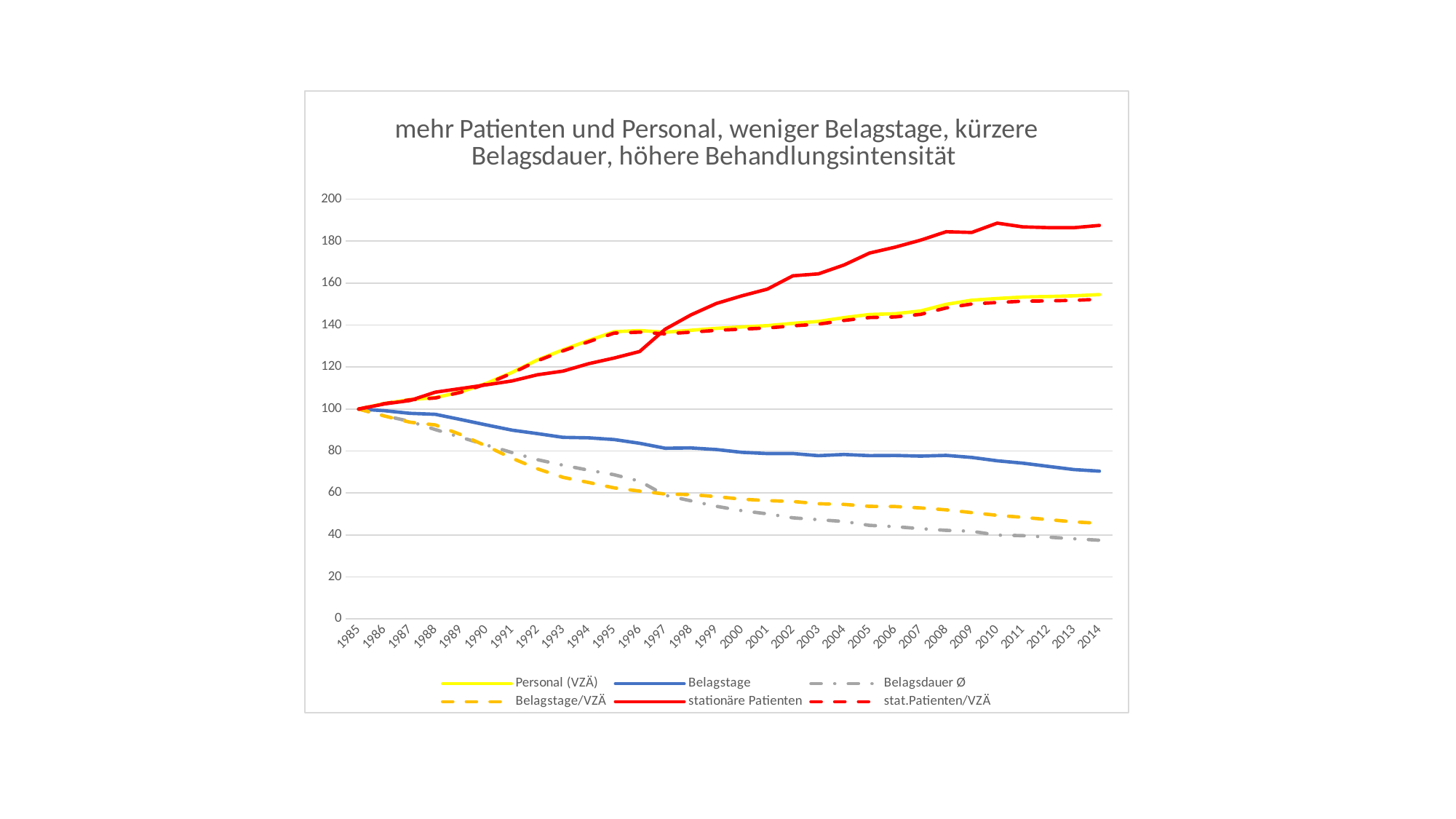
How many series does the legend list? 6 Which series has the lowest value in 2014? Belagsdauer Ø What is the value of Belagstage in 1985? 100 Is the value for Personal (VZÄ) in 2014 greater or less than 140? greater What kind of chart is shown on the slide? line chart Is the value for Belagsdauer Ø in 2014 greater or less than 60? less How many years are plotted along the x axis? 30 Do the values for Belagstage rise or fall from 1985 to 2014? fall Is the value for stationäre Patienten in 2014 greater or less than 180? greater Which series has the highest value in 2014? stationäre Patienten In 2014, which is larger: stationäre Patienten or Belagstage? stationäre Patienten